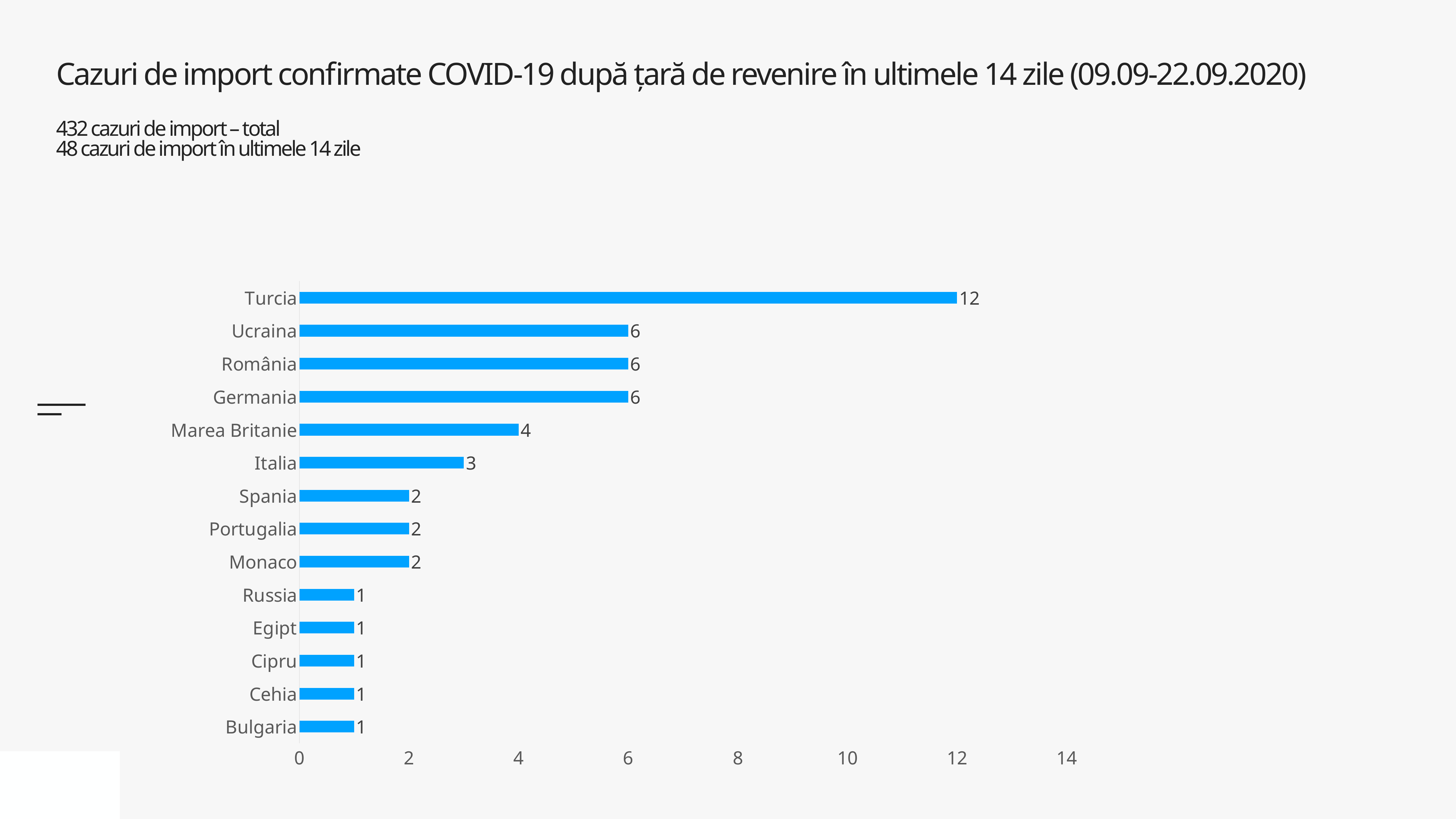
Which country has the highest value? Turcia What is the value for Italia? 3 How many countries have a value of 6? 3 What is the difference between the values for Turcia and Ucraina? 6 What is the difference between the values for Marea Britanie and Italia? 1 What is the value for Marea Britanie? 4 What is the value for Turcia? 12 Which is larger, the value for Germania or the value for Spania? Germania What is the value for Monaco? 2 How many countries are shown in the chart? 14 Is the value for Turcia greater or less than 10? greater What kind of chart is shown on the slide? bar chart